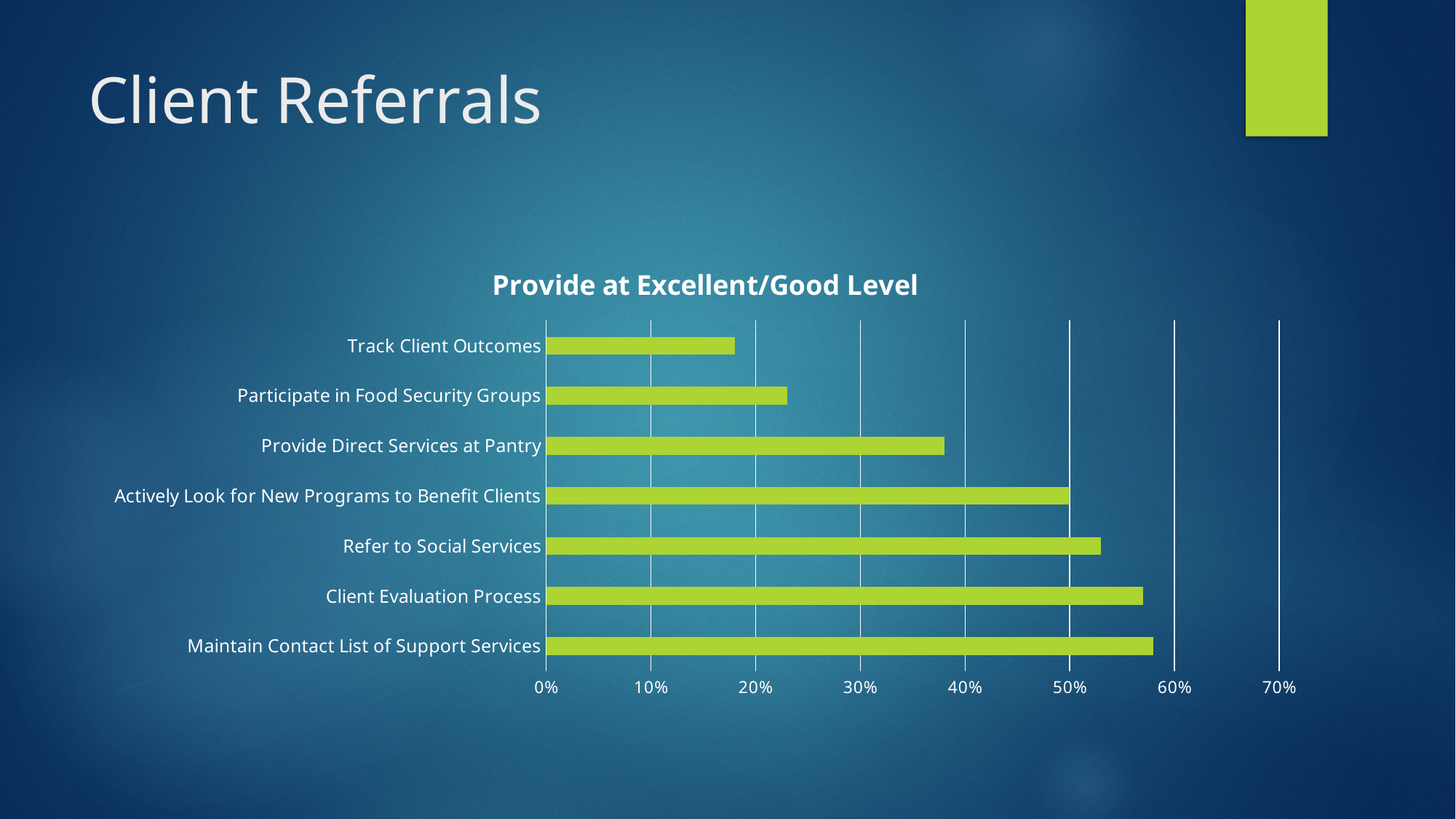
Is the value for Provide Direct Services at Pantry greater or less than 40%? less What is the highest value shown on the horizontal axis of the chart? 70% Is the value for Participate in Food Security Groups greater or less than 20%? greater Which is larger: the value for Provide Direct Services at Pantry or the value for Participate in Food Security Groups? Provide Direct Services at Pantry How many categories are plotted in the chart? 7 What is the title of the chart? Provide at Excellent/Good Level Which is larger: the value for Client Evaluation Process or the value for Provide Direct Services at Pantry? Client Evaluation Process Which category has the lowest value in the chart? Track Client Outcomes Is the value for Track Client Outcomes greater or less than 20%? less What kind of chart is shown on the slide? Bar chart